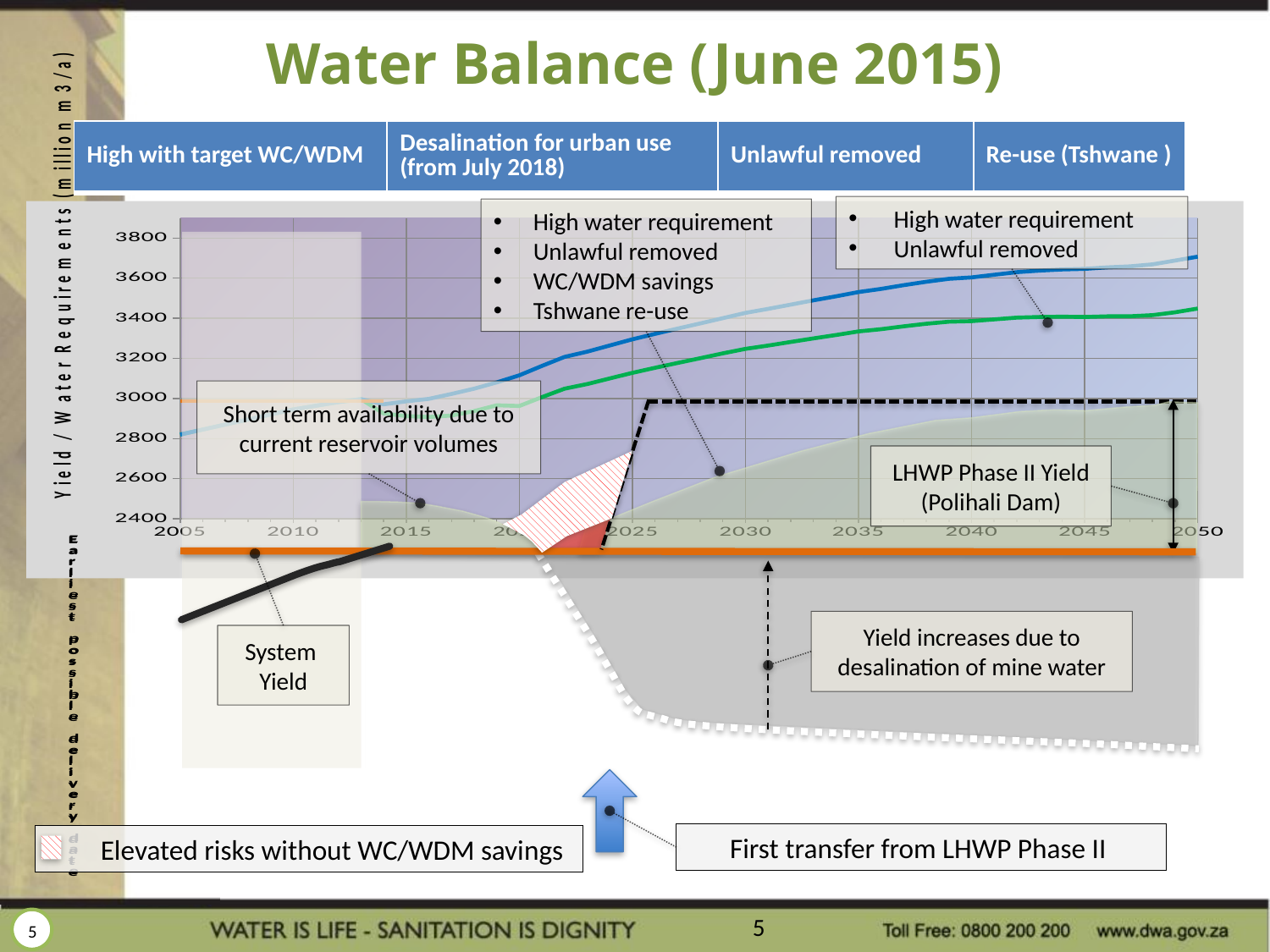
Which line is higher in 2050, the light blue line or the green line? the light blue line Is the value of the light blue (high water requirement, unlawful removed) line in 2050 greater or less than 3600? greater How many year labels are shown along the x axis of the chart? 10 Does the light blue water requirement line rise or fall from 2005 to 2050? rise What is the label on the vertical axis of the chart? Yield / Water Requirements (million m3/a) What kind of chart is shown on the slide? line chart What is the lowest value labelled on the y axis of the chart? 2400 What is the title of the chart on the slide? Water Balance (June 2015) Is the value of the light blue (high water requirement, unlawful removed) line in 2005 greater or less than 3000? less What is the highest value labelled on the y axis of the chart? 3800